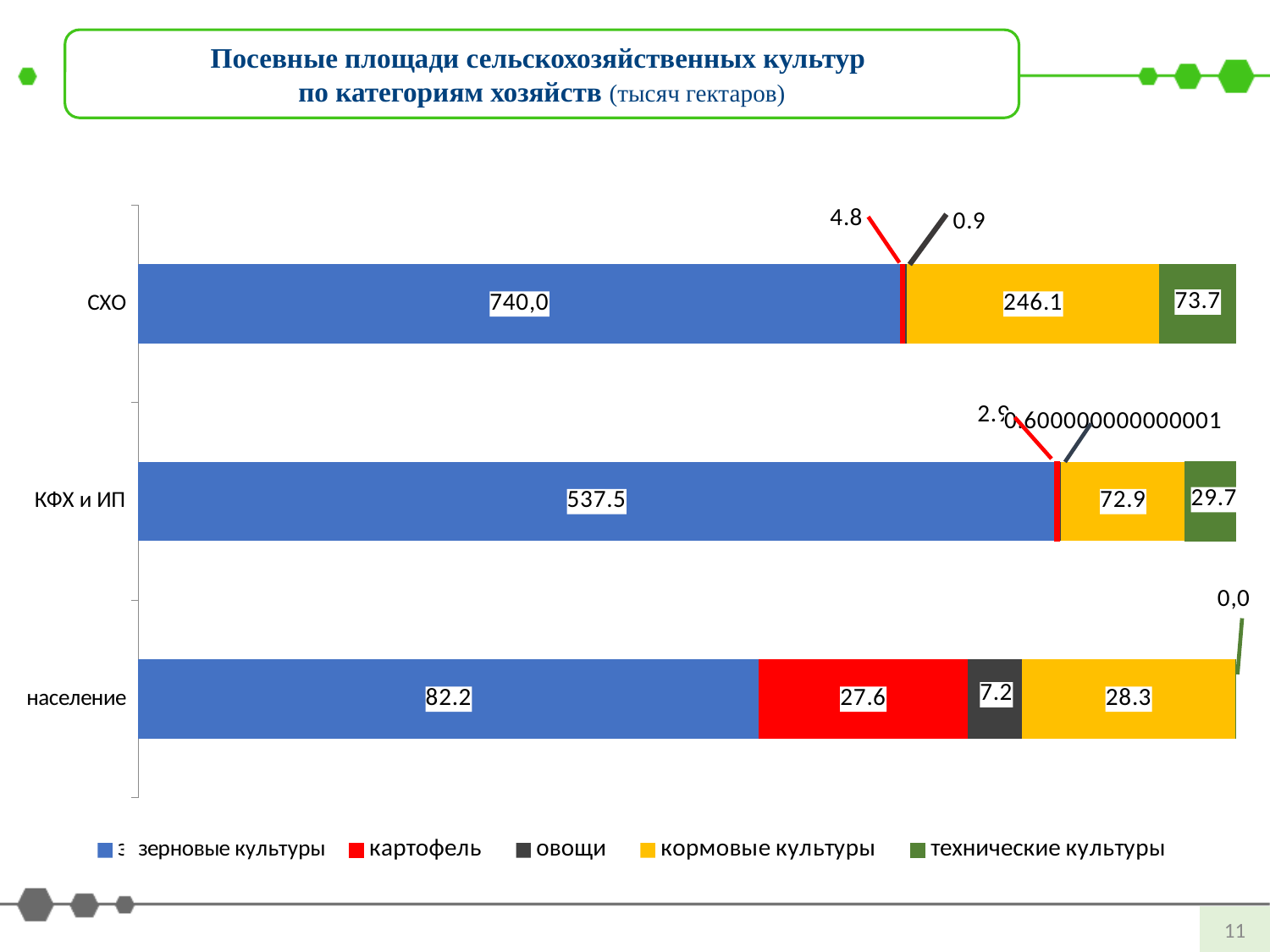
What is the value of овощи for население? 7.2 What is the value of зерновые культуры for СХО? 740,0 How many farm categories are shown on the chart? 3 What is the value of кормовые культуры for КФХ и ИП? 72.9 Which farm category has the highest value for зерновые культуры? СХО What type of chart is shown on the slide? stacked bar chart What is the value of технические культуры for СХО? 73.7 How many series does the legend list? 5 What is the total of the stacked bar for население? 145.3 What is the value of картофель for население? 27.6 What is the difference between the зерновые культуры values for СХО and КФХ и ИП? 202.5 Which farm category has the lowest value for кормовые культуры? население